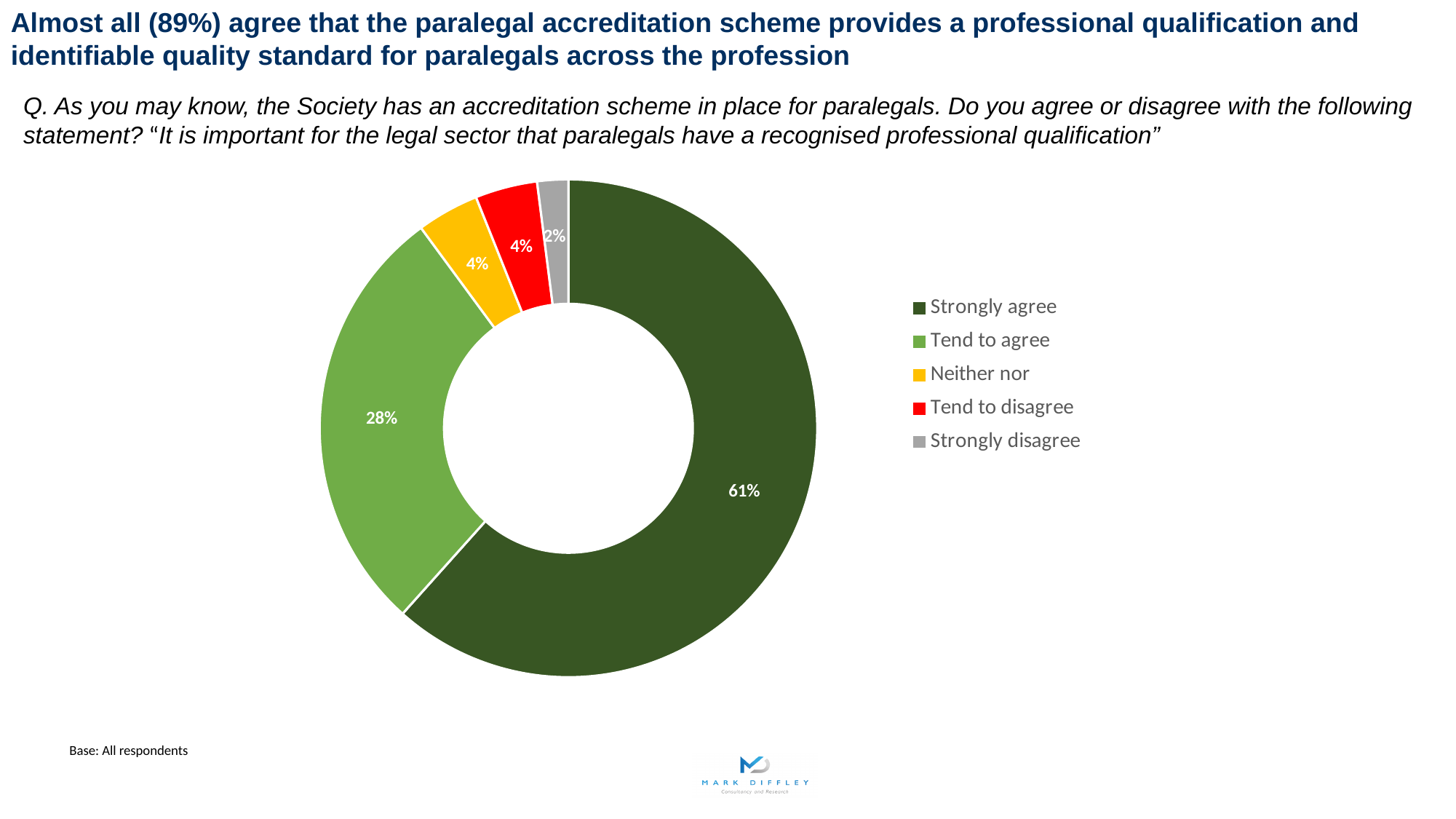
What percentage of respondents strongly agree? 61% Which response category has the smallest share? Strongly disagree What is the difference in percentage points between 'Strongly agree' and 'Tend to agree'? 33 What type of chart is shown on the slide? Doughnut (pie) chart What percentage of respondents answered 'Neither nor'? 4% What colour represents 'Tend to disagree' in the chart? Red What percentage of respondents tend to agree? 28% Which response category has the largest share? Strongly agree How many response categories are shown in the chart? 5 What is the combined percentage of 'Strongly agree' and 'Tend to agree'? 89% What percentage of respondents strongly disagree? 2% Which is larger, the share for 'Tend to agree' or the share for 'Tend to disagree'? Tend to agree